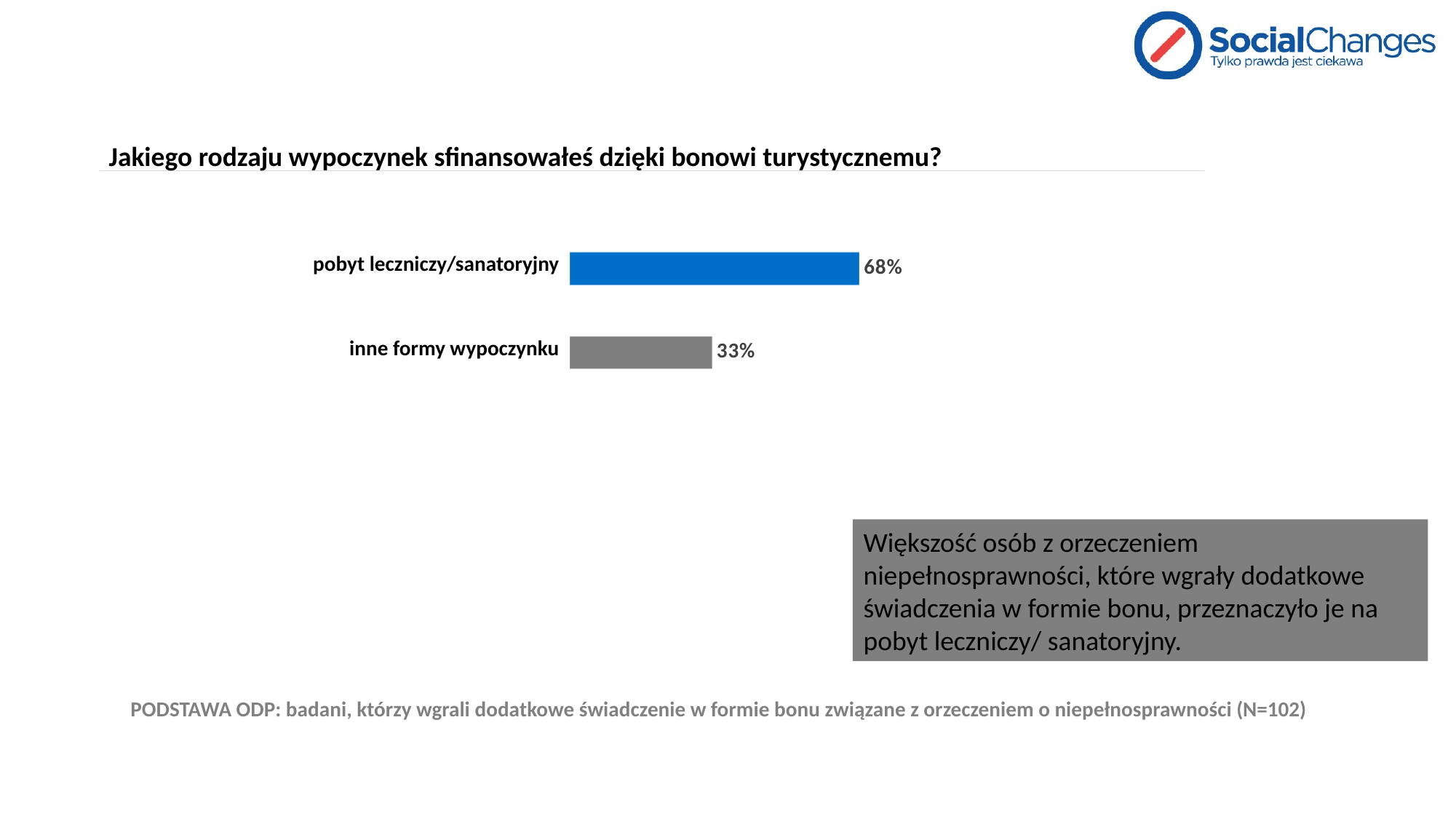
What is the value for 'inne formy wypoczynku'? 33% Which category has the highest value? pobyt leczniczy/sanatoryjny How many categories are shown in the chart? 2 Which category has the lowest value? inne formy wypoczynku What colour is the bar for 'pobyt leczniczy/sanatoryjny'? blue What is the value for 'pobyt leczniczy/sanatoryjny'? 68% Which is larger: the value for 'pobyt leczniczy/sanatoryjny' or for 'inne formy wypoczynku'? pobyt leczniczy/sanatoryjny What kind of chart is shown on the slide? bar chart What is the difference between the values for 'pobyt leczniczy/sanatoryjny' and 'inne formy wypoczynku'? 35 percentage points What is the title of the chart? Jakiego rodzaju wypoczynek sfinansowałeś dzięki bonowi turystycznemu?